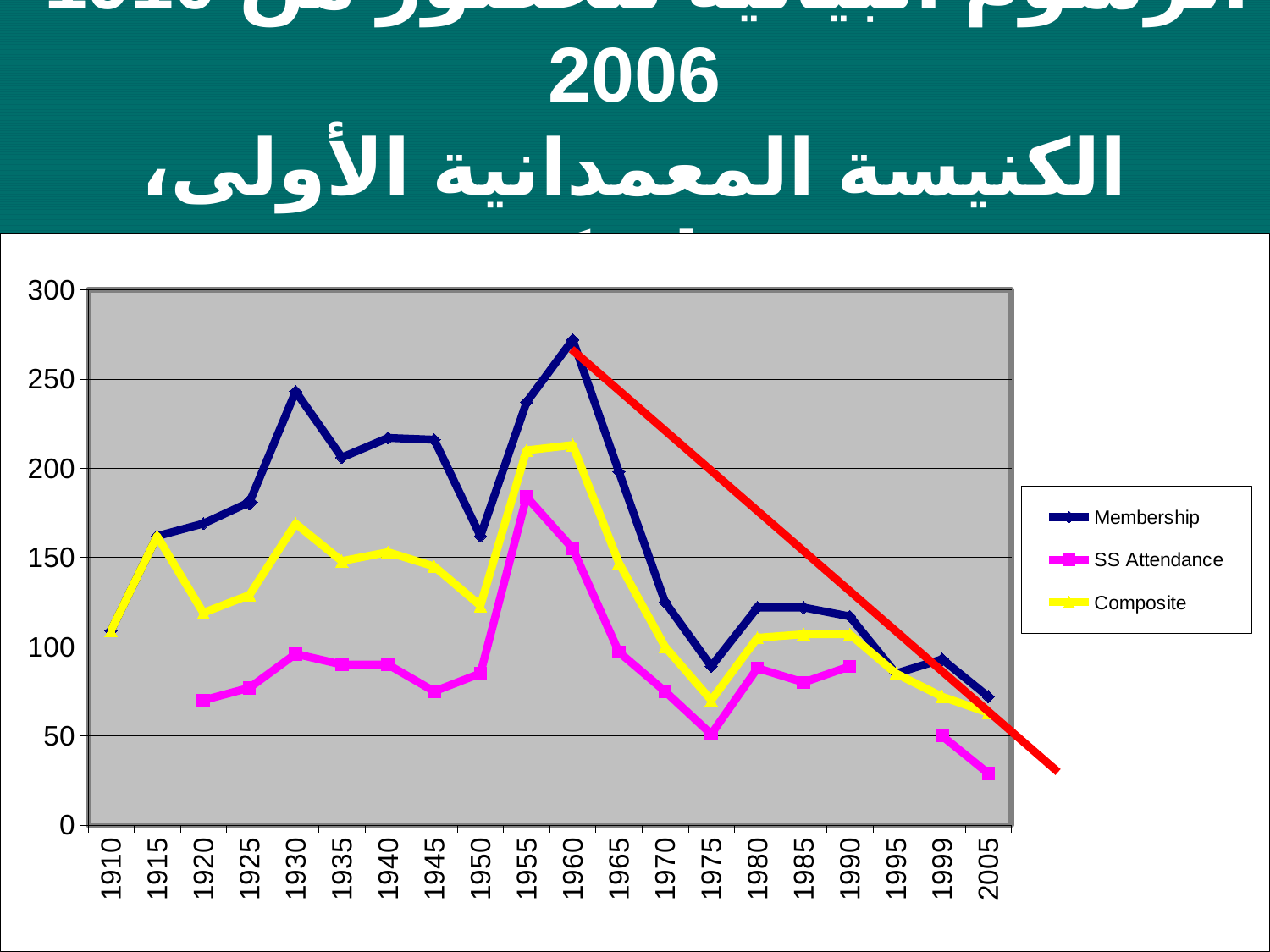
What colour is the Membership line in the legend? dark blue How many year labels are shown along the x axis? 20 Is the Composite value for 1955 greater or less than 200? greater Does the Membership series rise or fall between 1960 and 1975? fall Is the Membership value for 1975 greater or less than 100? less In which year does the SS Attendance series reach its lowest value? 2005 What kind of chart is shown on the slide? line chart In 1960, which is larger: Membership or SS Attendance? Membership Is the SS Attendance value for 2005 greater or less than 50? less How many series does the legend list? 3 In which year does the Membership series reach its highest value? 1960